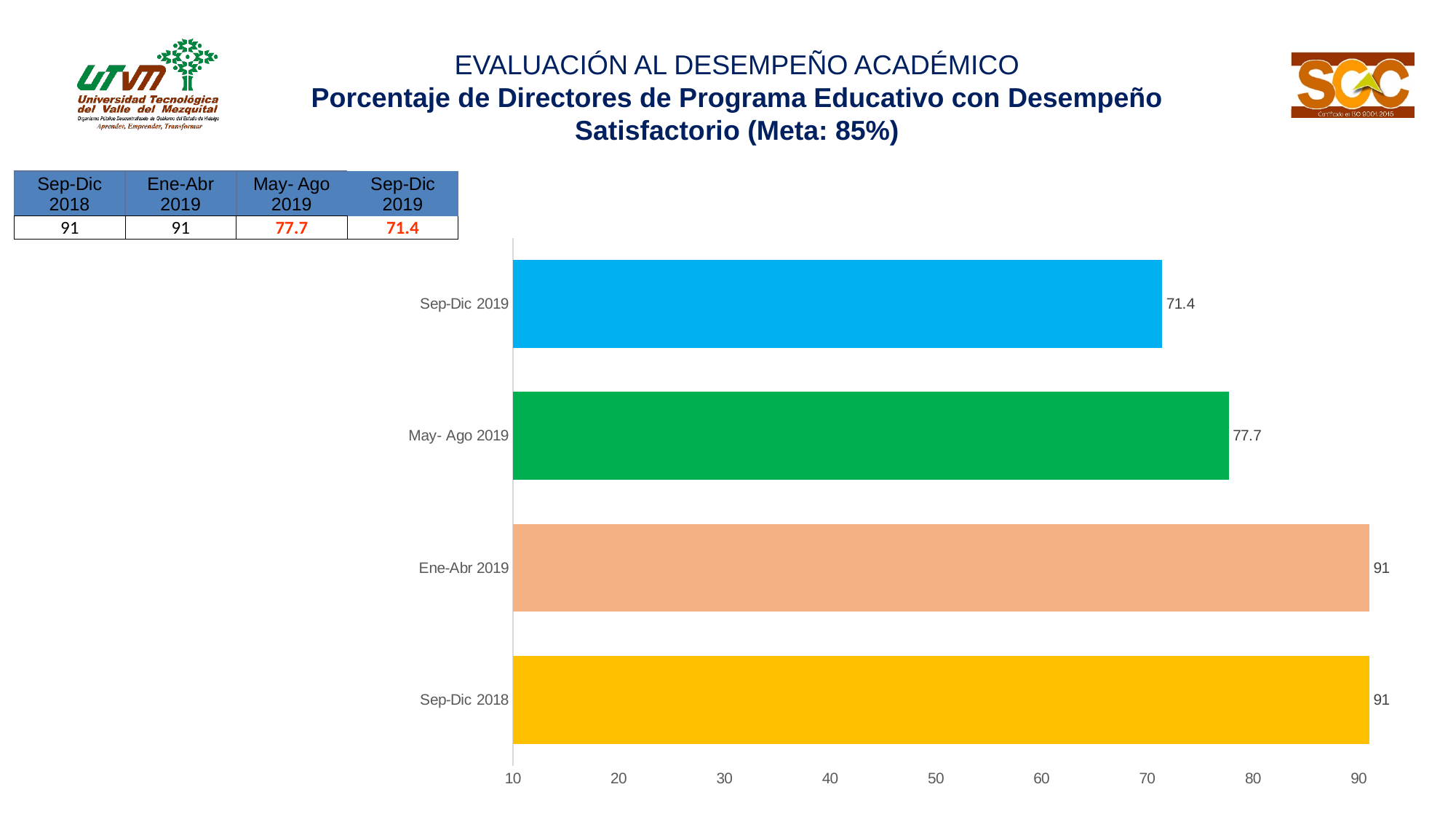
What is the value for Sep-Dic 2019? 71.4 What is the value for May- Ago 2019? 77.7 Is the value for Sep-Dic 2019 greater or less than 80? less What is the difference between the values for Ene-Abr 2019 and May- Ago 2019? 13.3 What is the difference between the values for May- Ago 2019 and Sep-Dic 2019? 6.3 Which period has the lowest value? Sep-Dic 2019 Which is larger, the value for May- Ago 2019 or the value for Sep-Dic 2019? May- Ago 2019 What is the value for Sep-Dic 2018? 91 What is the target (Meta) stated in the slide title? 85% What kind of chart is shown on the slide? bar chart What is the value for Ene-Abr 2019? 91 How many periods are shown in the chart? 4